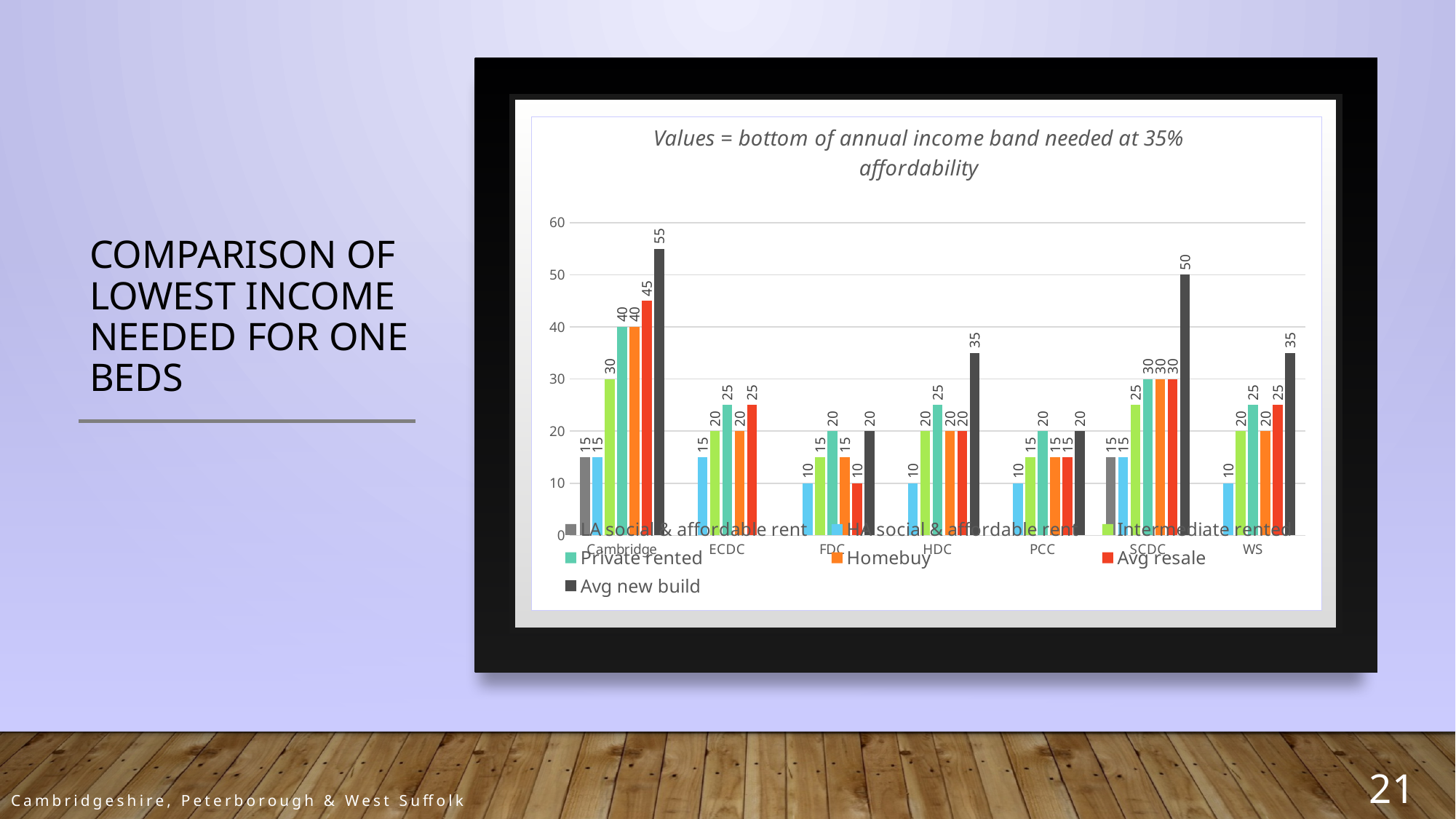
Which is larger, the Avg resale value for Cambridge or the Avg resale value for SCDC? Cambridge How many series does the legend list? 7 What is the difference between the Avg new build values for Cambridge and SCDC? 5 Which category has the highest Avg new build value? Cambridge What is the value for Intermediate rented in Cambridge? 30 How many categories are shown on the x axis? 7 What is the value for Avg new build in Cambridge? 55 What is the value for Avg new build in SCDC? 50 What is the value for Private rented in HDC? 25 What is the title of the chart? Values = bottom of annual income band needed at 35% affordability What kind of chart is shown on the slide? Bar chart What is the value for HA social & affordable rent in FDC? 10